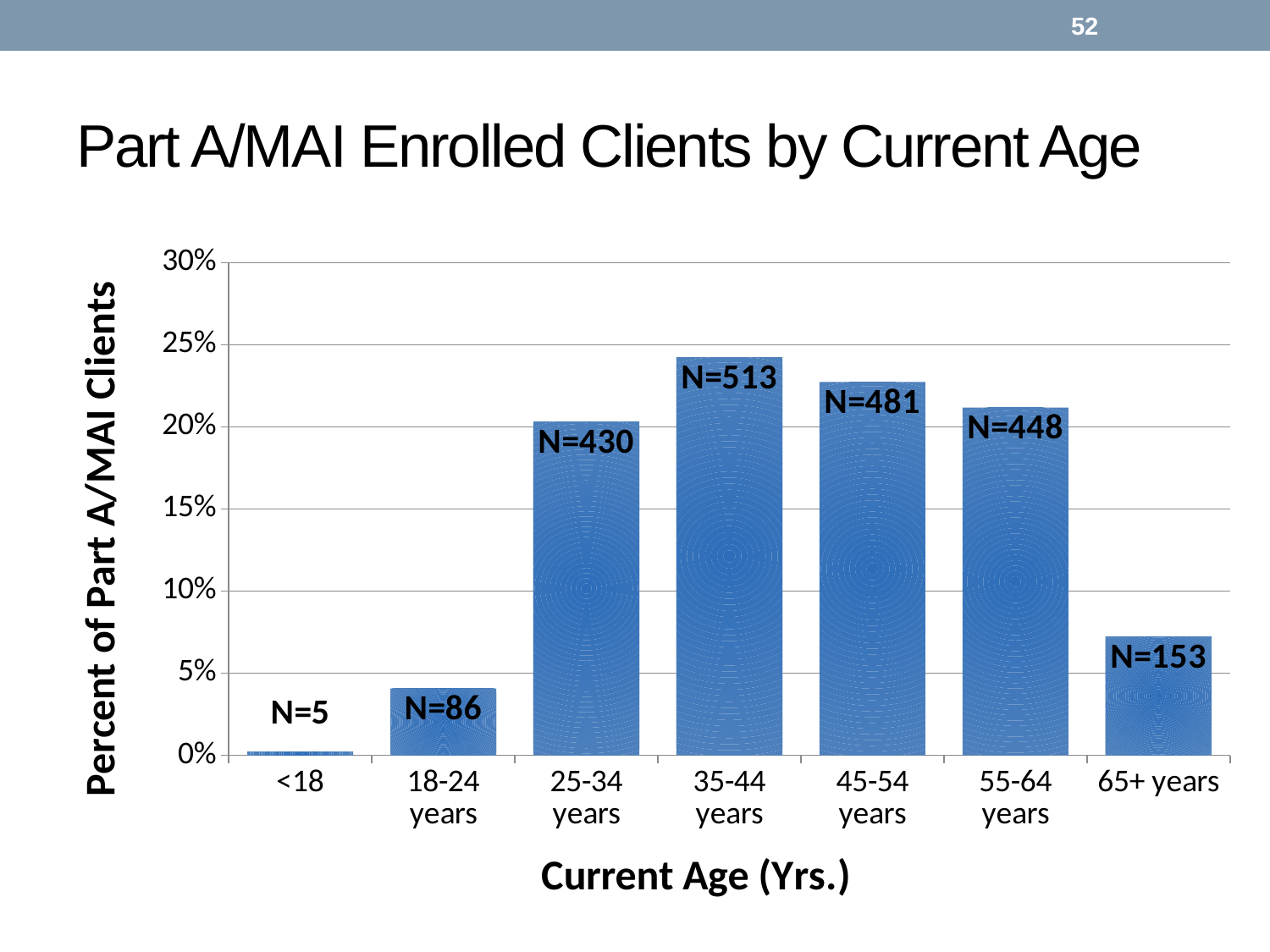
Is the percent of clients aged 65+ years greater or less than 10%? less What kind of chart is shown on the slide? bar chart What is the title of the chart? Part A/MAI Enrolled Clients by Current Age What is the difference between the N values for the 35-44 years and 25-34 years age groups? 83 Which age group has a higher percent of clients, 45-54 years or 55-64 years? 45-54 years How many age categories are shown on the x axis? 7 Which age group has the lowest percent of Part A/MAI clients? <18 What is the N value printed for the <18 age group? N=5 Which age group has the highest percent of Part A/MAI clients? 35-44 years What is the N value printed for the 65+ years age group? N=153 What is the N value printed for the 35-44 years age group? N=513